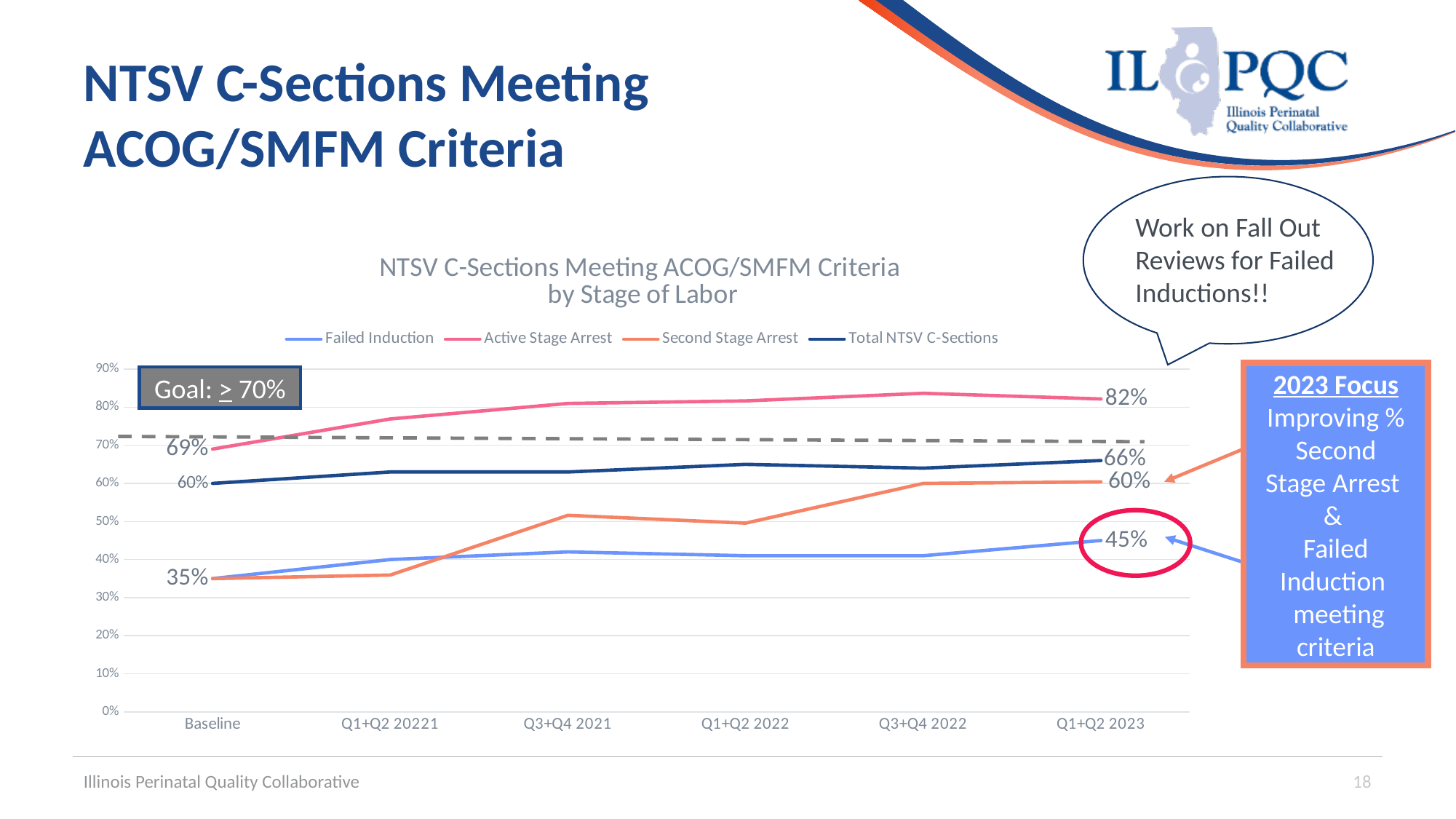
How many time periods are plotted along the x axis? 6 By how many percentage points did Active Stage Arrest change from Baseline (69%) to Q1+Q2 2023 (82%)? 13 percentage points Which series has the highest value at Q1+Q2 2023? Active Stage Arrest What is the value for Failed Induction at Q1+Q2 2023? 45% Is the value for Failed Induction at Q1+Q2 2022 greater or less than 50%? less What is the value for Second Stage Arrest at Q1+Q2 2023? 60% What is the value for Active Stage Arrest at Q1+Q2 2023? 82% How many series does the chart legend list? 4 What is the value for Total NTSV C-Sections at Baseline? 60% What kind of chart is shown on the slide? line chart By how many percentage points did Total NTSV C-Sections change from Baseline to Q1+Q2 2023? 6 percentage points Which series has the lowest value at Q1+Q2 2023? Failed Induction